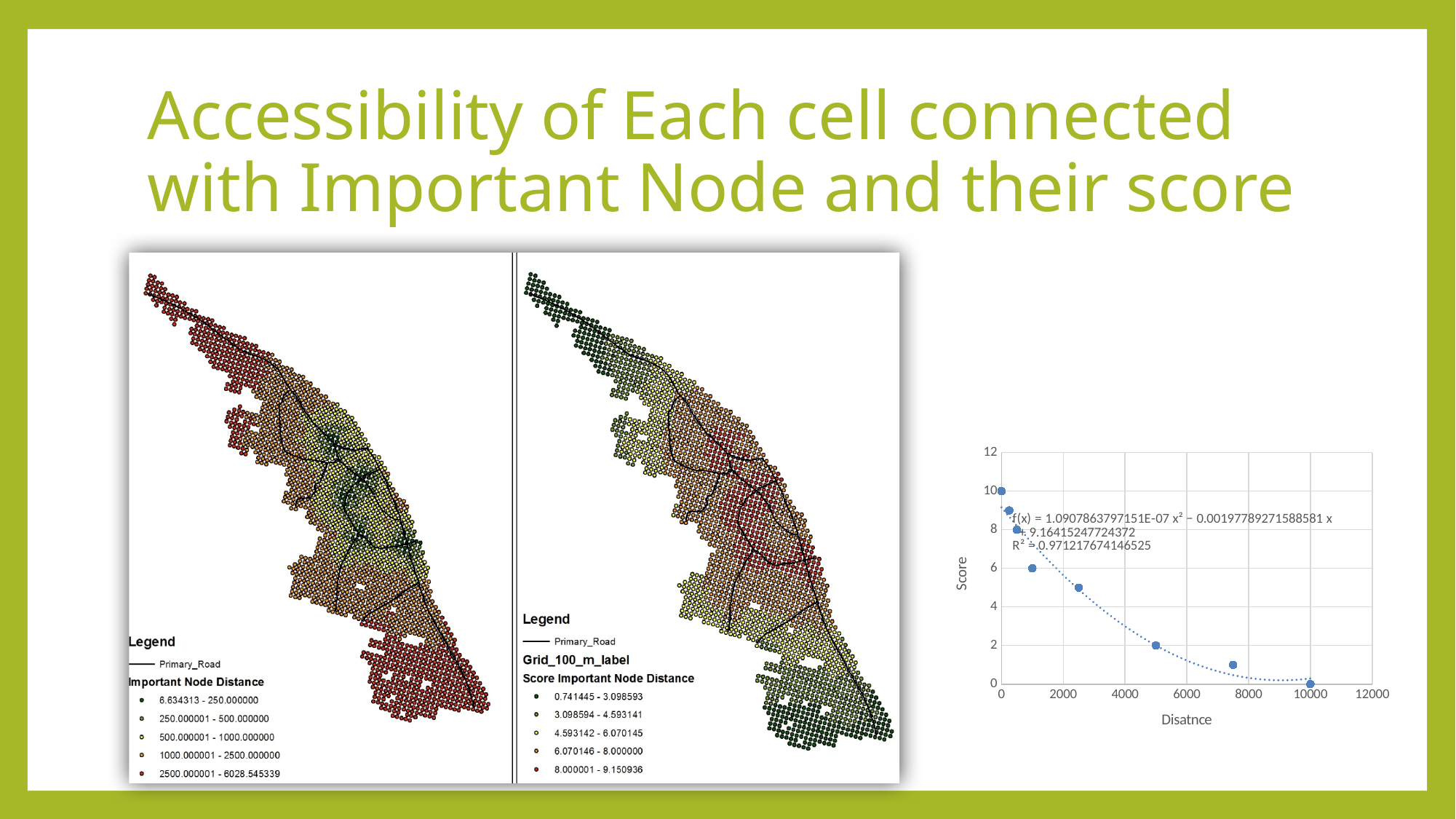
In the scatter chart of Score versus Distance, what is the Score at a distance of 10000? 0 What R² value is printed on the scatter chart? 0.971217674146525 In the scatter chart, which distance has the lowest Score? 10000 In the scatter chart, do the Score values rise or fall as Distance increases? fall In the scatter chart, is the Score at a distance of 5000 greater or less than 4? less In the scatter chart of Score versus Distance, what is the Score at a distance of 0? 10 What kind of chart is shown on the right side of the slide? scatter chart How many data points are plotted in the scatter chart? 8 In the scatter chart, which distance has the highest Score? 0 What is the label on the vertical axis of the scatter chart? Score In the scatter chart, which has the larger Score: the point at distance 1000 or the point at distance 7500? distance 1000 In the scatter chart, is the Score at a distance of 2500 greater or less than 4? greater